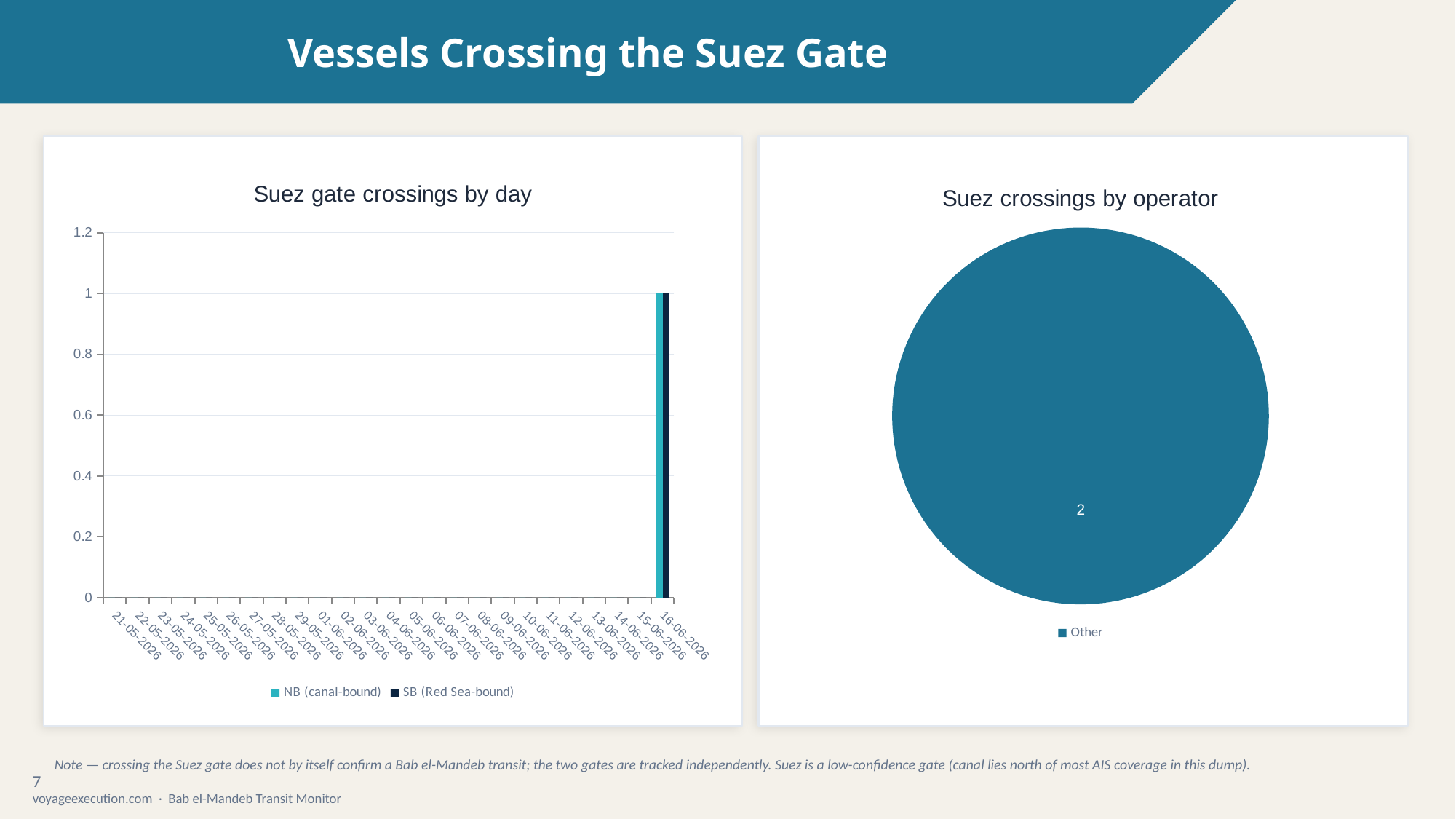
In "Suez gate crossings by day", what are the two legend entries? NB (canal-bound), SB (Red Sea-bound) In "Suez crossings by operator", what value is shown for the Other slice? 2 In "Suez gate crossings by day", what is the value for SB (Red Sea-bound) on 16-06-2026? 1 In "Suez gate crossings by day", how many series does the legend list? 2 What kind of chart is "Suez gate crossings by day"? bar chart In "Suez gate crossings by day", which date has the highest number of crossings? 16-06-2026 In "Suez crossings by operator", how many slices does the pie have? 1 In "Suez gate crossings by day", is the value for NB (canal-bound) on 16-06-2026 greater or less than 0.8? greater In "Suez gate crossings by day", how many dates are shown on the x axis? 25 In "Suez crossings by operator", what share of the pie does the Other slice take? 100% What kind of chart is "Suez crossings by operator"? pie chart In "Suez gate crossings by day", what is the value for NB (canal-bound) on 16-06-2026? 1